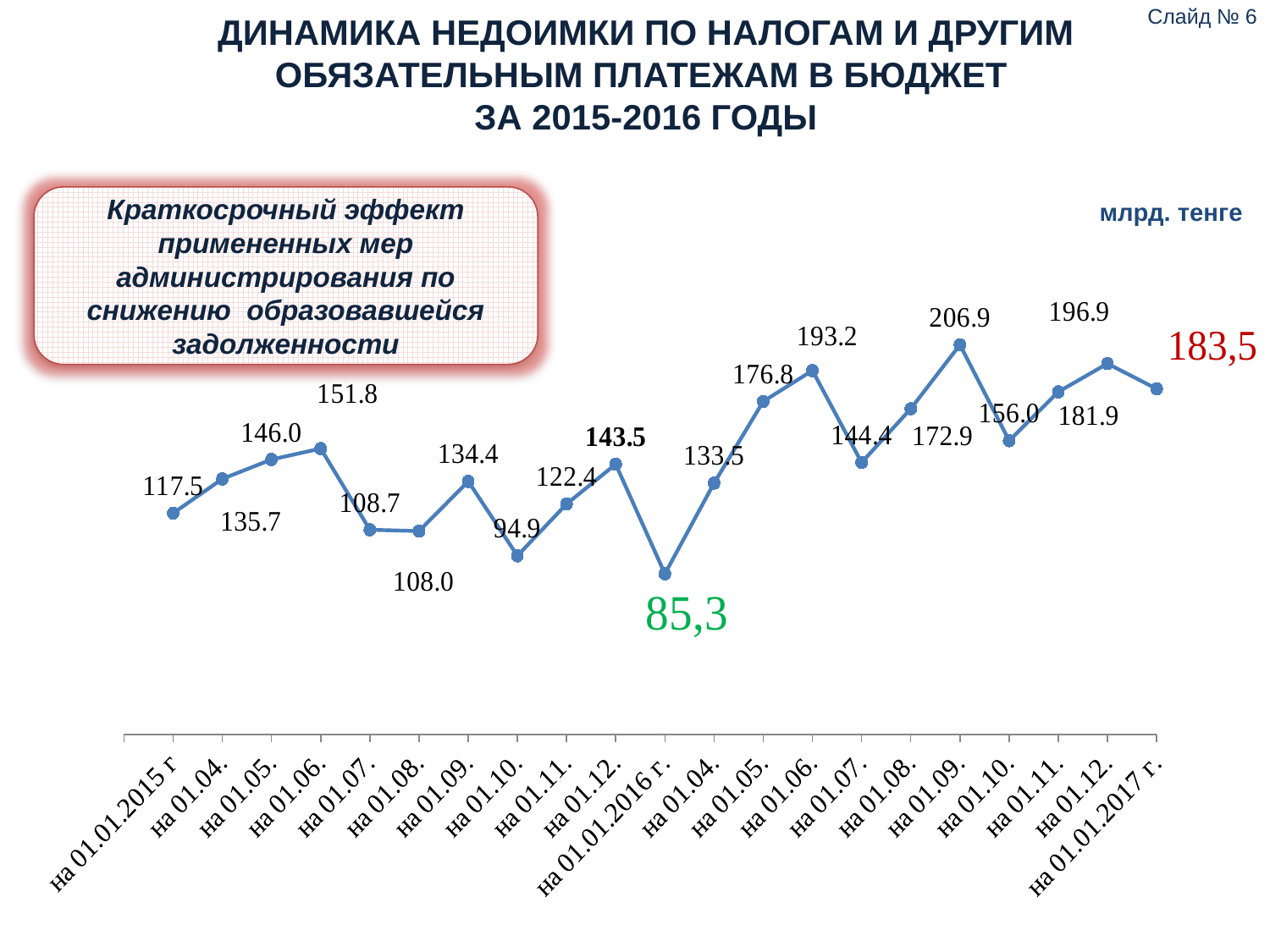
Does the value rise or fall from на 01.01.2016 г. to на 01.01.2017 г.? rise What is the difference between the value for на 01.01.2017 г. and the value for на 01.01.2016 г.? 98.2 What kind of chart is shown on the slide? line chart What is the lowest value plotted on the chart? 85,3 What is the value for на 01.01.2017 г.? 183,5 What is the difference between the value for на 01.01.2015 г and the value for на 01.01.2016 г.? 32.2 What unit of measurement is indicated for the chart? млрд. тенге What is the highest value plotted on the chart? 206.9 How many data points are plotted on the chart? 21 Which is larger, the value for на 01.01.2015 г or the value for на 01.01.2017 г.? на 01.01.2017 г. What is the value for на 01.01.2016 г.? 85,3 What is the value for на 01.01.2015 г? 117.5